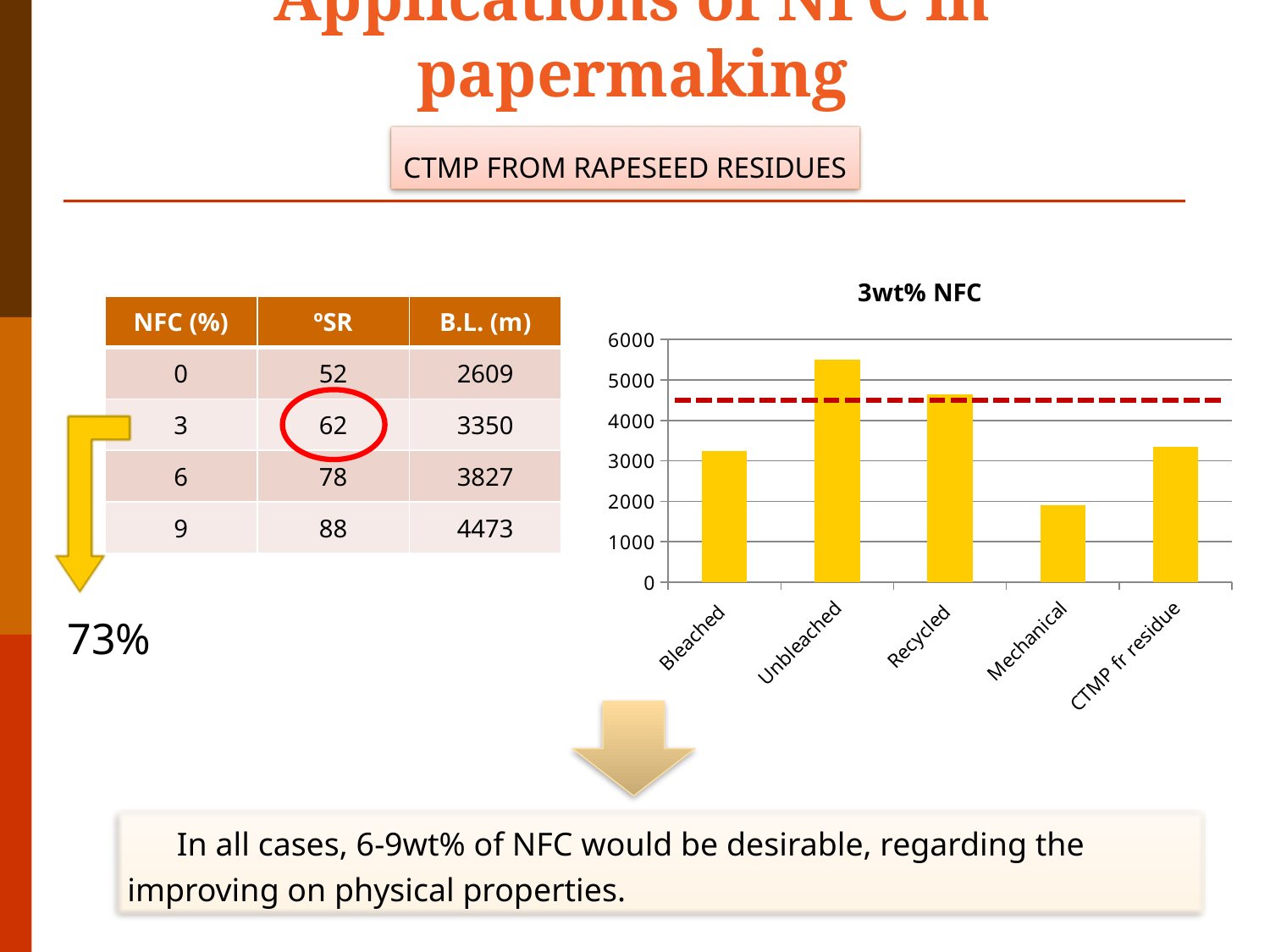
In the "3wt% NFC" chart, is the value for Bleached greater or less than 3000? greater What kind of chart is shown under the title "3wt% NFC"? bar chart In the "3wt% NFC" chart, is the value for Unbleached greater or less than 5000? greater In the "3wt% NFC" chart, is the value for Recycled greater or less than 4000? greater Which category has the lowest bar in the "3wt% NFC" chart? Mechanical In the "3wt% NFC" chart, which is larger, the value for Unbleached or the value for Recycled? Unbleached How many categories are plotted on the x axis of the "3wt% NFC" chart? 5 Which category has the highest bar in the "3wt% NFC" chart? Unbleached What is the title of the bar chart on the slide? 3wt% NFC In the "3wt% NFC" chart, which is larger, the value for Mechanical or the value for Bleached? Bleached